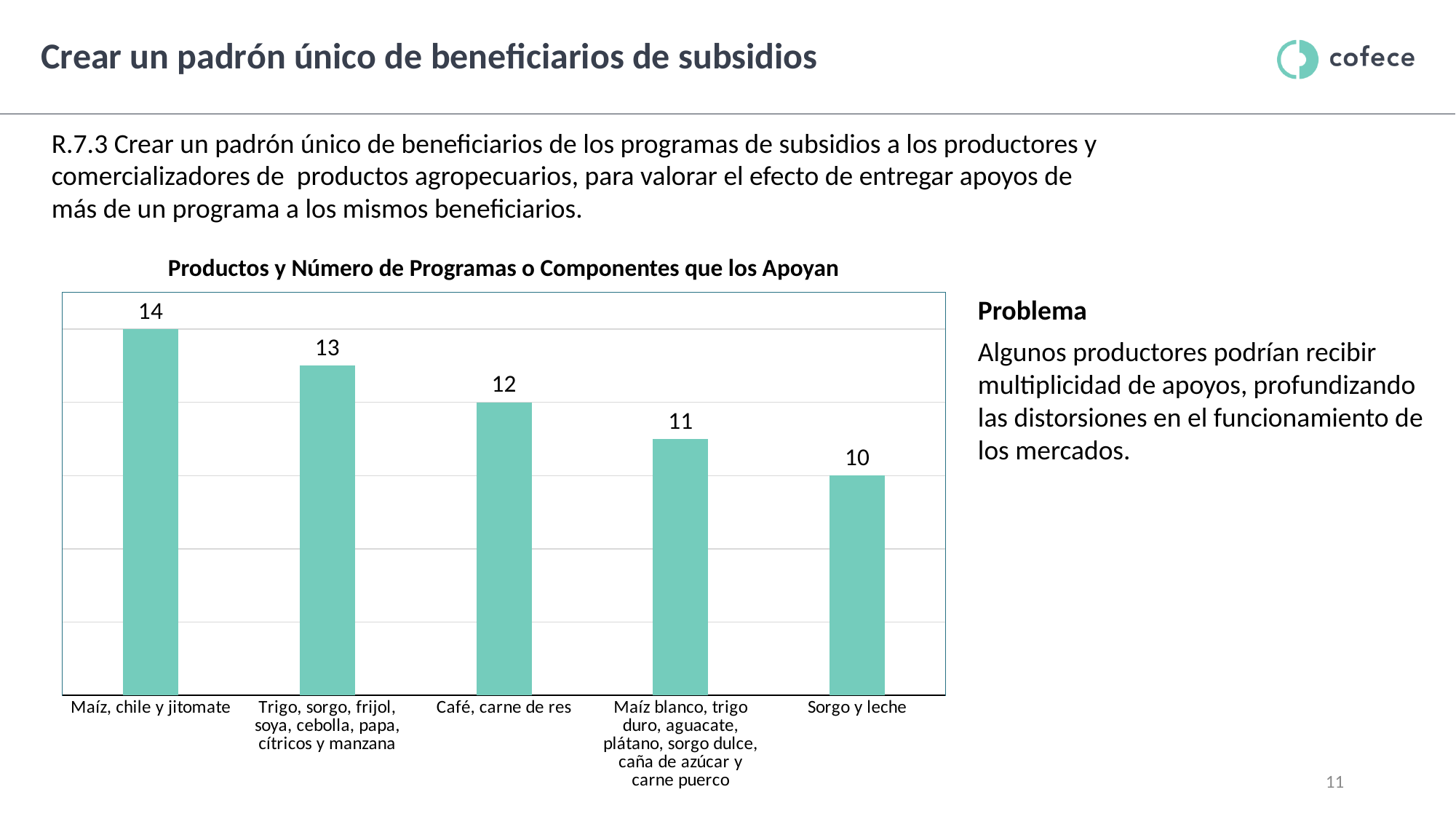
What is the value for "Sorgo y leche"? 10 What is the title of the chart? Productos y Número de Programas o Componentes que los Apoyan What is the difference between the values for "Maíz, chile y jitomate" and "Sorgo y leche"? 4 What kind of chart is shown on the slide? Bar chart What is the value for "Café, carne de res"? 12 Which category has the highest value? Maíz, chile y jitomate What is the value for "Trigo, sorgo, frijol, soya, cebolla, papa, cítricos y manzana"? 13 Which is larger, the value for "Café, carne de res" or the value for "Sorgo y leche"? Café, carne de res What is the value for "Maíz, chile y jitomate"? 14 Do the values rise or fall from left to right along the x axis? Fall How many categories are shown in the chart? 5 Which category has the lowest value? Sorgo y leche